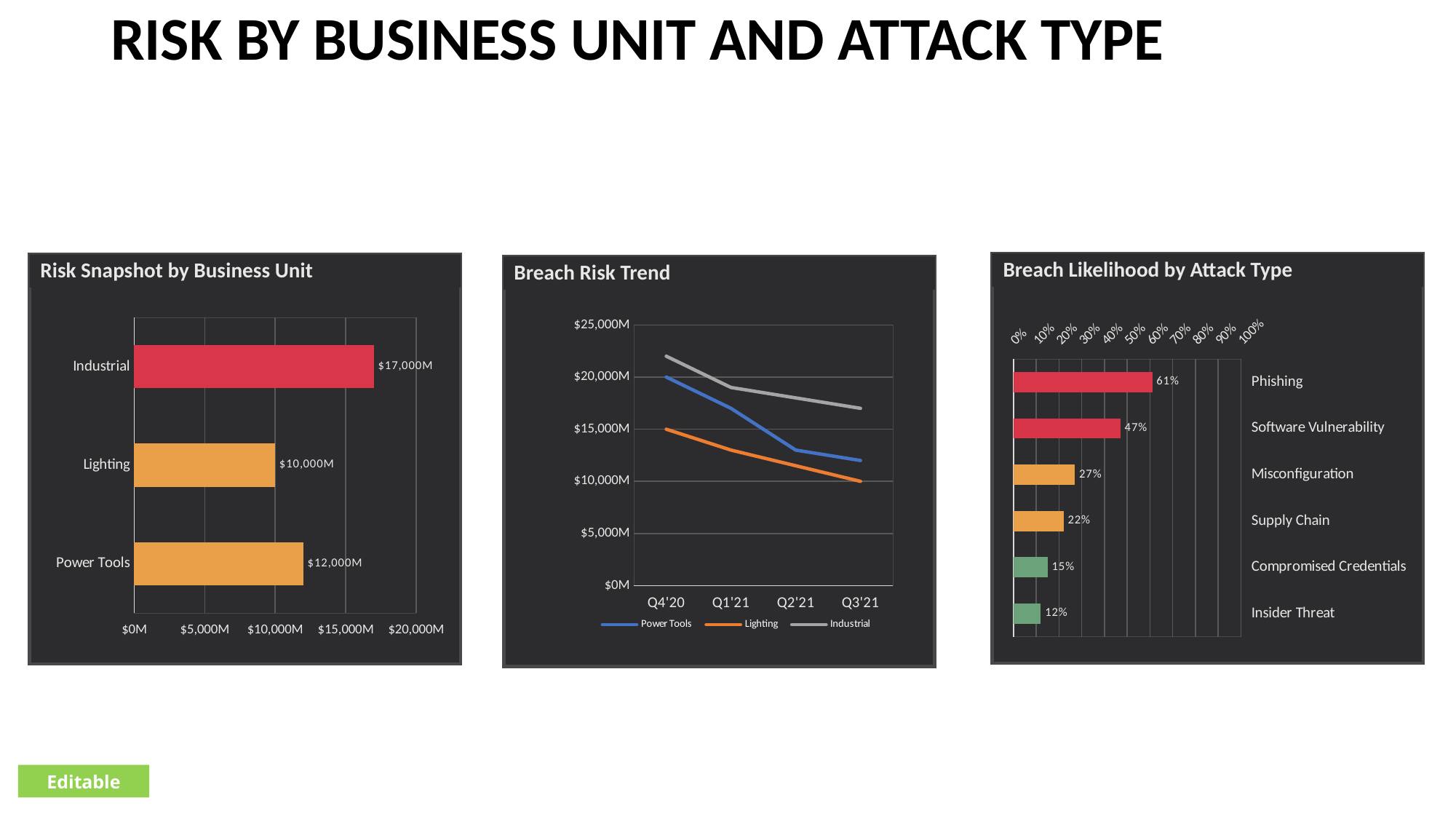
In the Risk Snapshot by Business Unit chart, which business unit has the lowest value? Lighting In the Breach Risk Trend chart, does the Industrial line rise or fall from Q4'20 to Q3'21? Fall In the Risk Snapshot by Business Unit chart, what is the value for Industrial? $17,000M In the Breach Risk Trend chart, which series has the highest value at Q3'21? Industrial In the Breach Likelihood by Attack Type chart, which attack type has the highest likelihood? Phishing In the Breach Likelihood by Attack Type chart, which is larger, Misconfiguration or Supply Chain? Misconfiguration In the Risk Snapshot by Business Unit chart, what is the difference between Industrial and Power Tools? $5,000M In the Breach Likelihood by Attack Type chart, what is the value for Software Vulnerability? 47% How many series does the legend of the Breach Risk Trend chart list? 3 What kind of chart is the Breach Risk Trend chart? Line chart In the Risk Snapshot by Business Unit chart, how many business units are shown? 3 In the Breach Risk Trend chart, is the value for Industrial at Q4'20 greater or less than $20,000M? greater